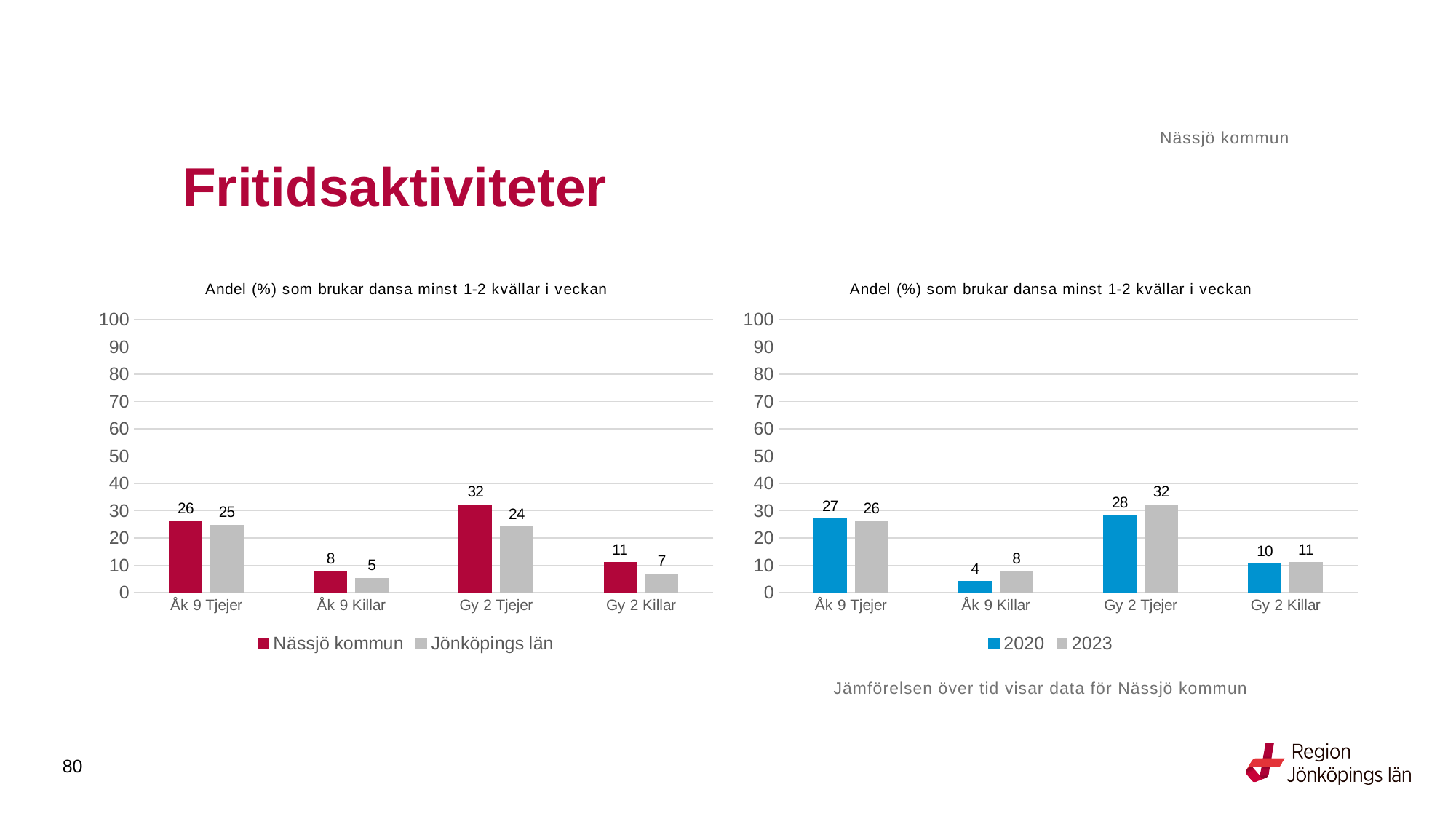
How many series does the legend of the right chart list? 2 In the left chart, what is the value for Nässjö kommun for Gy 2 Tjejer? 32 How many categories are shown on the x axis of the left chart? 4 In the right chart, which is larger for Gy 2 Tjejer: the 2020 value or the 2023 value? 2023 In the right chart, what is the 2020 value for Åk 9 Killar? 4 In the right chart, what is the difference between the 2023 and 2020 values for Åk 9 Killar? 4 In the left chart, what is the difference between Nässjö kommun and Jönköpings län for Gy 2 Tjejer? 8 In the right chart, what is the 2023 value for Gy 2 Tjejer? 32 What kind of chart is the left chart? Bar chart In the left chart, which category has the lowest value for Jönköpings län? Åk 9 Killar In the right chart, which category has the highest 2023 value? Gy 2 Tjejer In the left chart, what is the value for Jönköpings län for Åk 9 Killar? 5